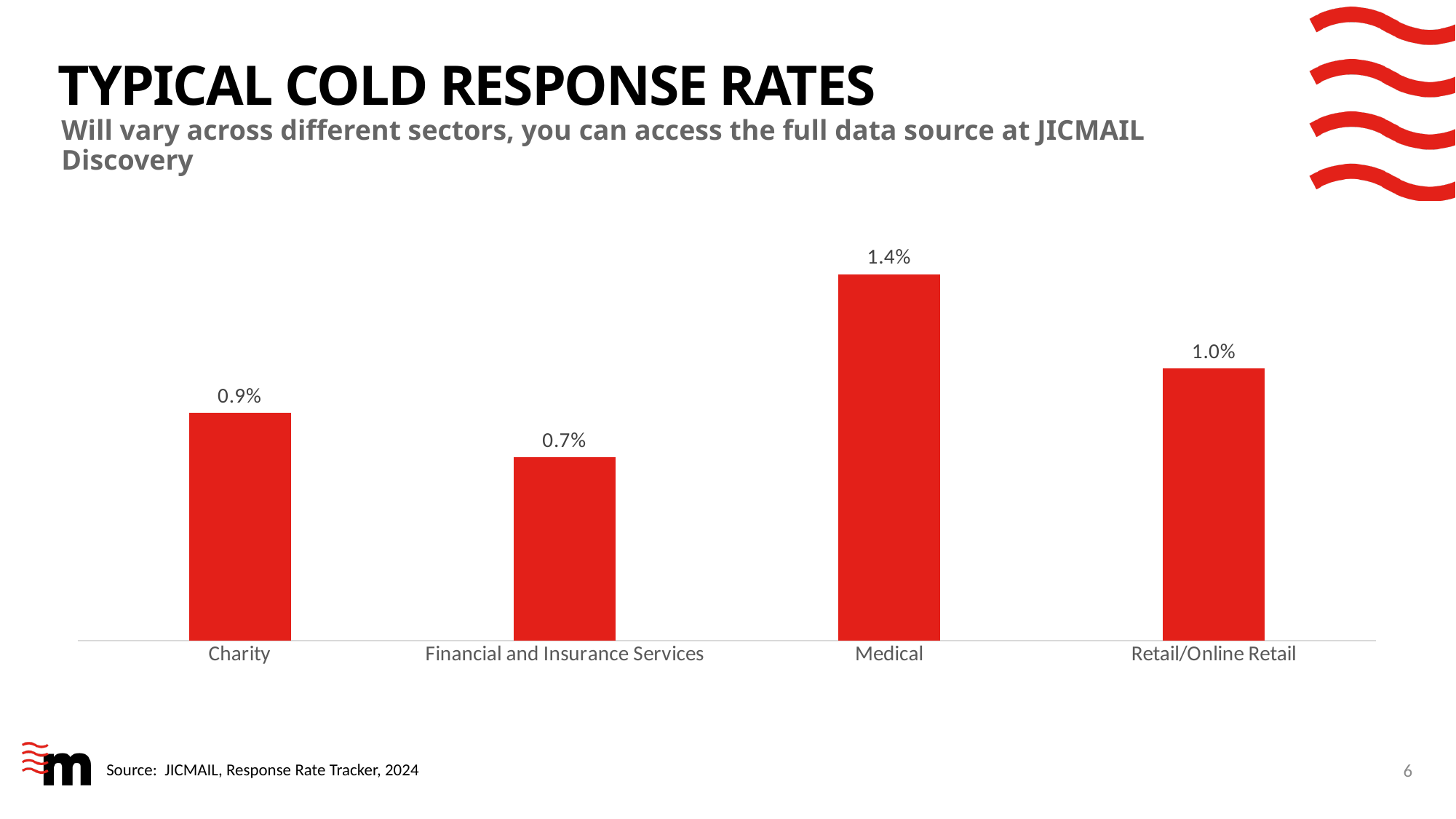
What is the cold response rate for Retail/Online Retail? 1.0% What is the cold response rate for Financial and Insurance Services? 0.7% Which has a higher cold response rate, Charity or Retail/Online Retail? Retail/Online Retail What is the cold response rate for Medical? 1.4% How many sectors are shown in the chart? 4 What is the difference between the cold response rates for Medical and Financial and Insurance Services? 0.7% Which sector has the lowest cold response rate? Financial and Insurance Services Which sector has the highest cold response rate? Medical What kind of chart is shown on the slide? Bar chart What is the title of the slide containing the chart? TYPICAL COLD RESPONSE RATES What is the difference between the cold response rates for Retail/Online Retail and Charity? 0.1% What is the cold response rate for Charity? 0.9%